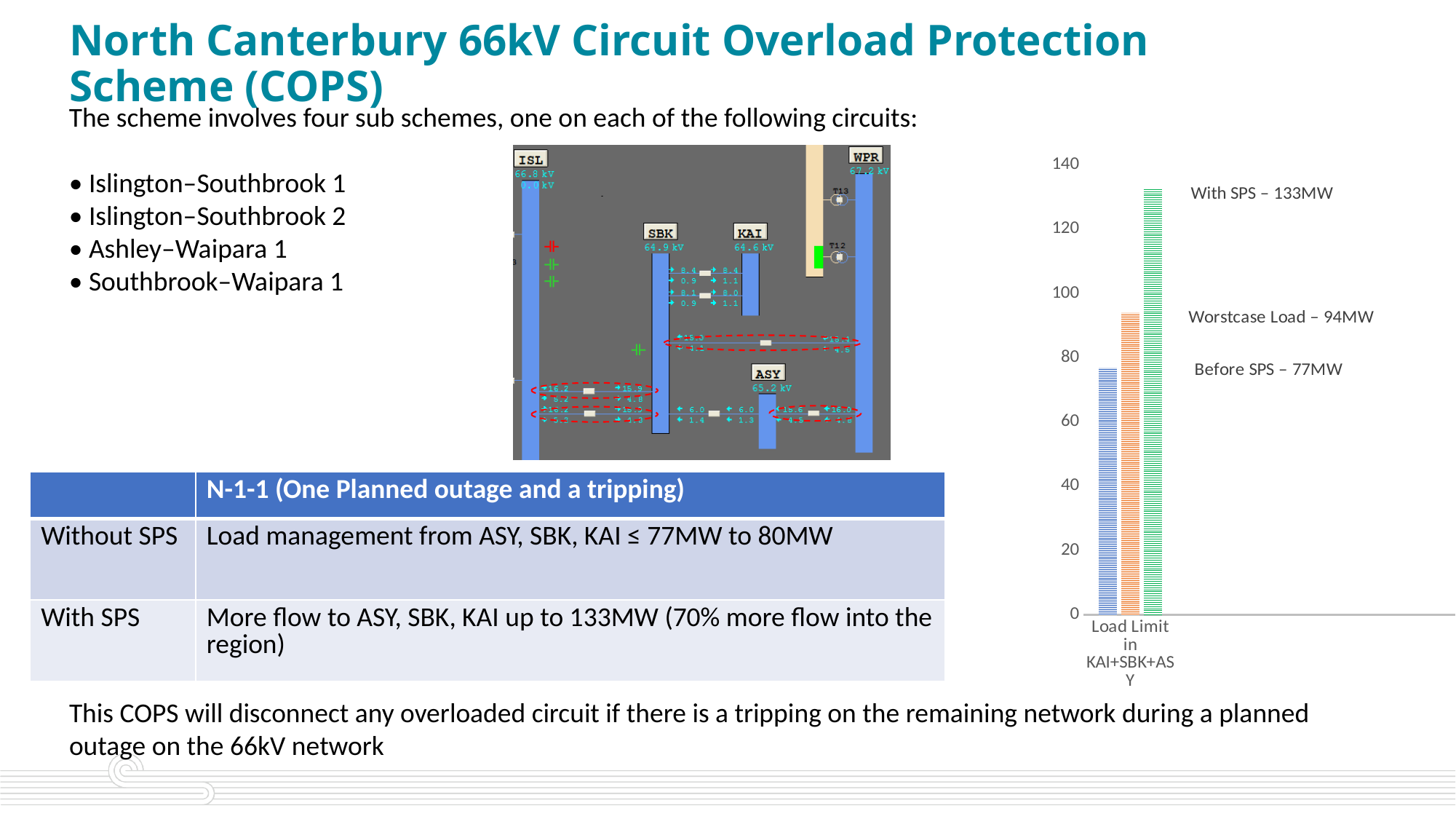
In the bar chart, which bar has the lowest value? Before SPS In the bar chart, what is the difference between the With SPS value and the Before SPS value? 56MW In the bar chart, which bar has the highest value? With SPS What is the category label shown on the x axis of the bar chart? Load Limit in KAI+SBK+ASY In the bar chart, what is the value labelled for With SPS? 133MW In the bar chart, what is the difference between the Worstcase Load value and the Before SPS value? 17MW How many bars are plotted in the bar chart? 3 In the bar chart, is the value for Before SPS greater or less than 80? less In the bar chart, what is the value labelled for Before SPS? 77MW In the bar chart, which is larger: Worstcase Load or Before SPS? Worstcase Load In the bar chart, what is the value labelled for Worstcase Load? 94MW What kind of chart is shown on the right side of the slide? bar chart